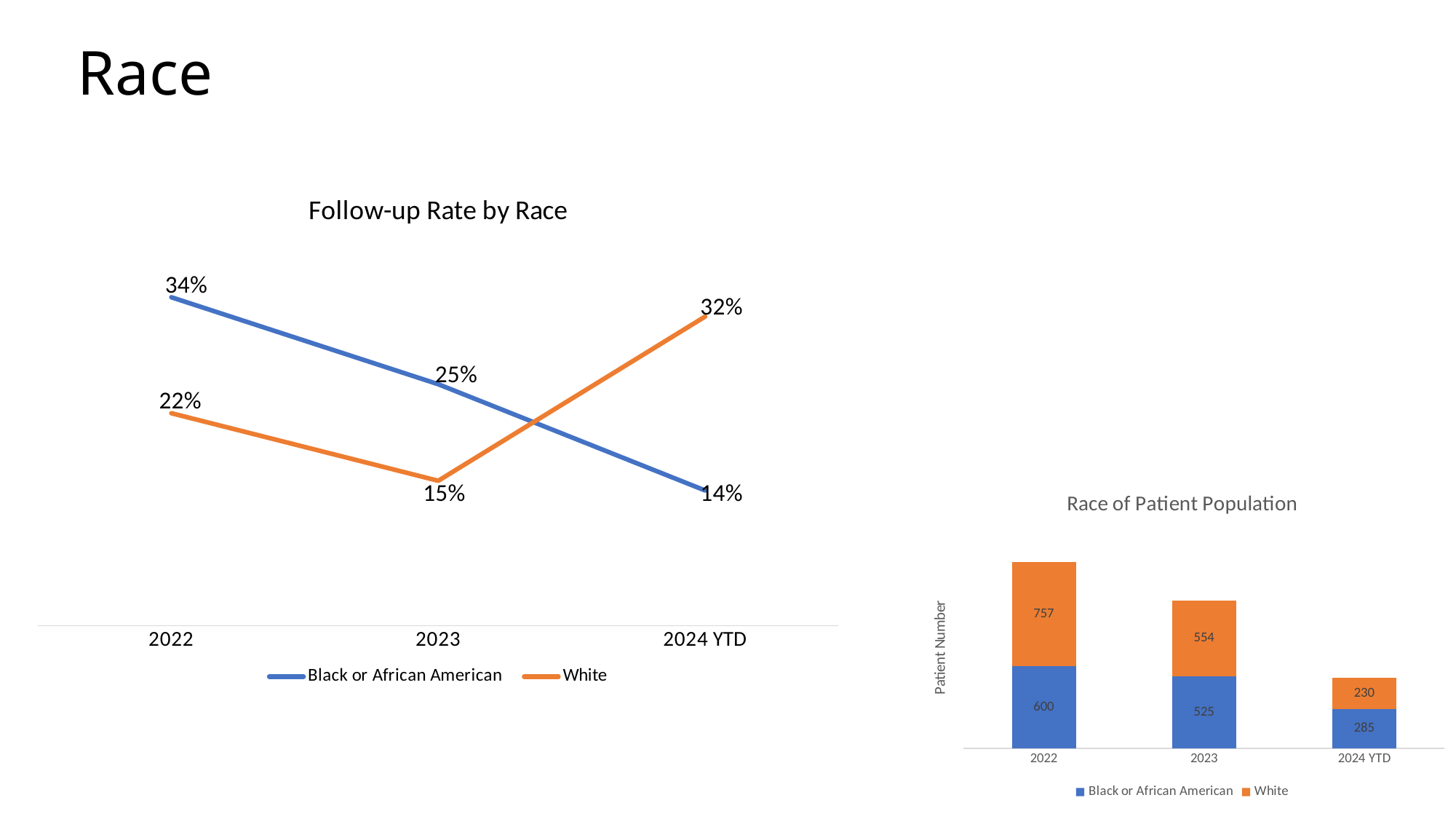
In the 'Race of Patient Population' chart, which year has the lowest total patient number? 2024 YTD In the 'Race of Patient Population' chart, what is the total number of patients for 2023? 1079 In the 'Race of Patient Population' chart, how many Black or African American patients are shown for 2024 YTD? 285 In the 'Follow-up Rate by Race' chart, what is the follow-up rate for Black or African American in 2022? 34% In the 'Follow-up Rate by Race' chart, does the Black or African American follow-up rate rise or fall from 2022 to 2024 YTD? fall In the 'Follow-up Rate by Race' chart, which series has the higher follow-up rate in 2023? Black or African American In the 'Race of Patient Population' chart, how many White patients are shown for 2022? 757 In the 'Follow-up Rate by Race' chart, what is the follow-up rate for White in 2023? 15% In the 'Follow-up Rate by Race' chart, what is the difference between the Black or African American and White follow-up rates in 2024 YTD? 18% How many series does the legend of the 'Race of Patient Population' chart list? 2 What kind of chart is 'Follow-up Rate by Race'? line chart In the 'Follow-up Rate by Race' chart, what is the follow-up rate for White in 2024 YTD? 32%